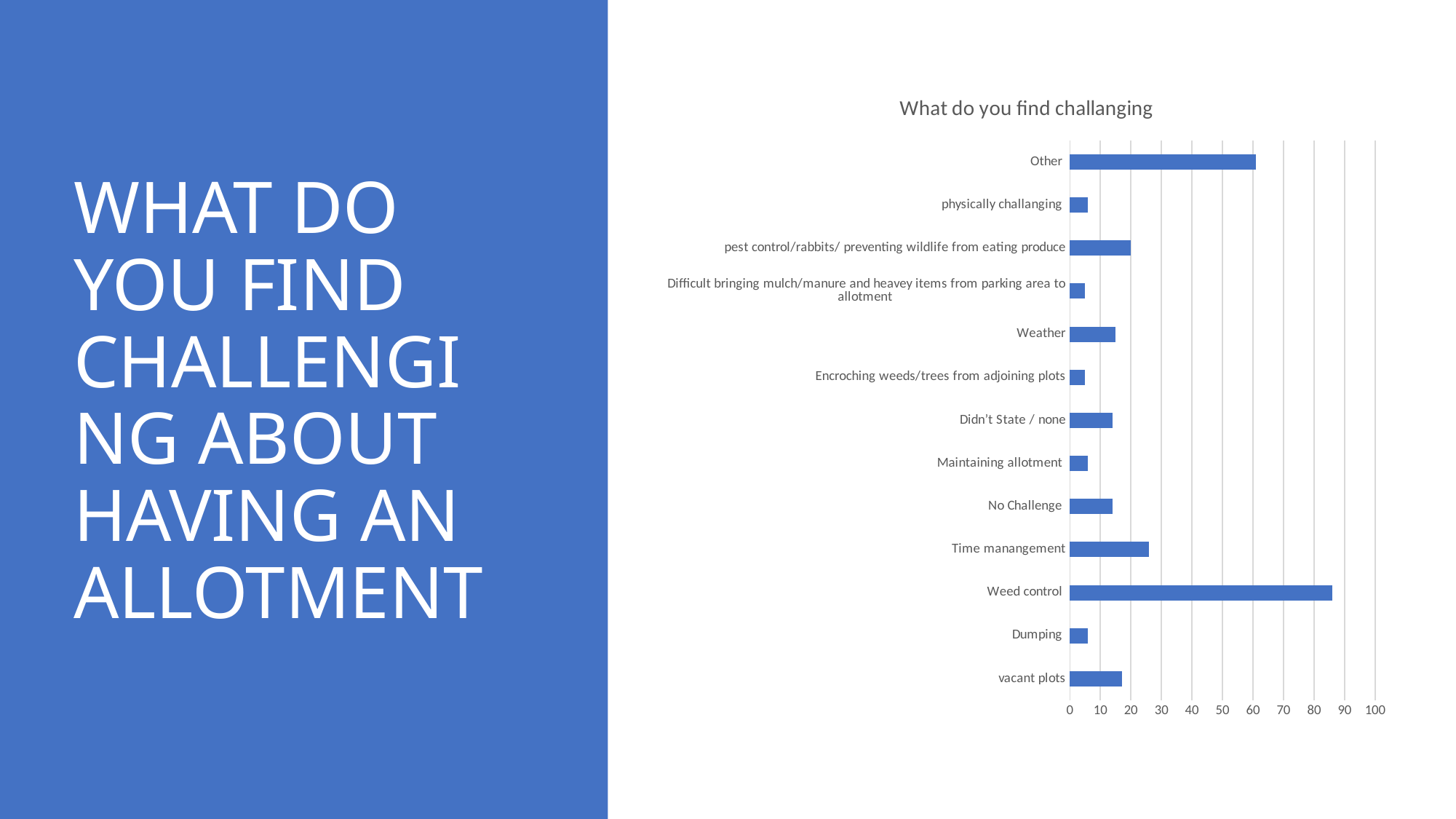
What is the title of the chart? What do you find challanging Is the value for Weather greater or less than 10? greater Which is larger, the value for Weed control or the value for Other? Weed control What kind of chart is shown on the slide? bar chart Is the value for Weed control greater or less than 80? greater How many categories are plotted in the chart? 13 Is the value for Dumping greater or less than 10? less Which is larger, the value for Other or the value for pest control/rabbits/ preventing wildlife from eating produce? Other Which is larger, the value for Time manangement or the value for Weather? Time manangement Which category has the highest value? Weed control